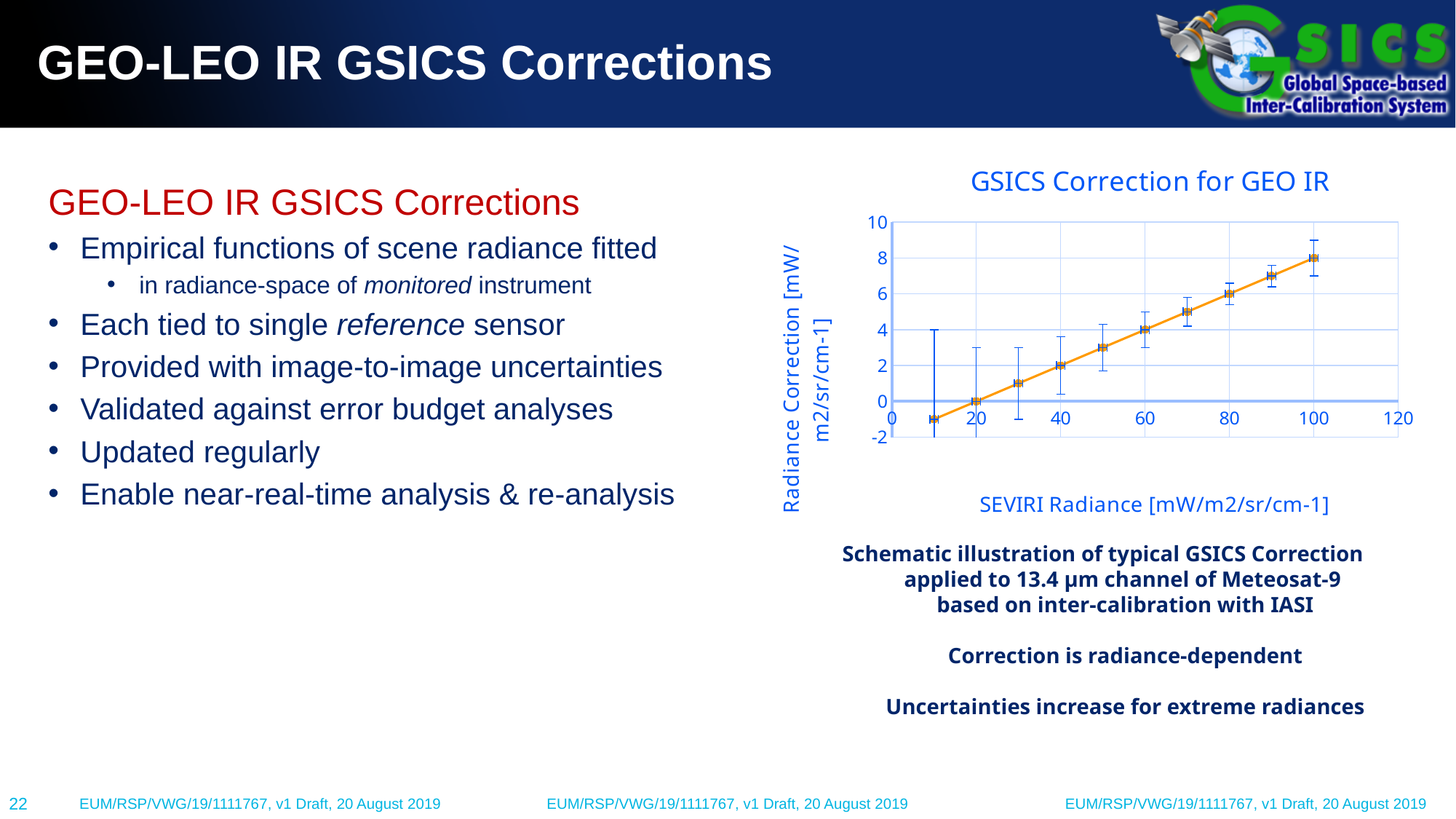
What is the label of the x axis of the chart? SEVIRI Radiance [mW/m2/sr/cm-1] What is the title of the chart? GSICS Correction for GEO IR What kind of chart is shown on the slide? line chart What is the Radiance Correction at a SEVIRI Radiance of 60? 4 Is the Radiance Correction at a SEVIRI Radiance of 10 greater or less than 0? less Do the plotted values rise or fall as SEVIRI Radiance increases along the x axis? rise What is the Radiance Correction at a SEVIRI Radiance of 100? 8 What is the Radiance Correction at a SEVIRI Radiance of 20? 0 What is the difference in Radiance Correction between SEVIRI Radiance 80 and SEVIRI Radiance 40? 4 At which SEVIRI Radiance value is the Radiance Correction highest? 100 Which is larger, the Radiance Correction at SEVIRI Radiance 40 or at SEVIRI Radiance 80? 80 How many data points are plotted on the chart? 10